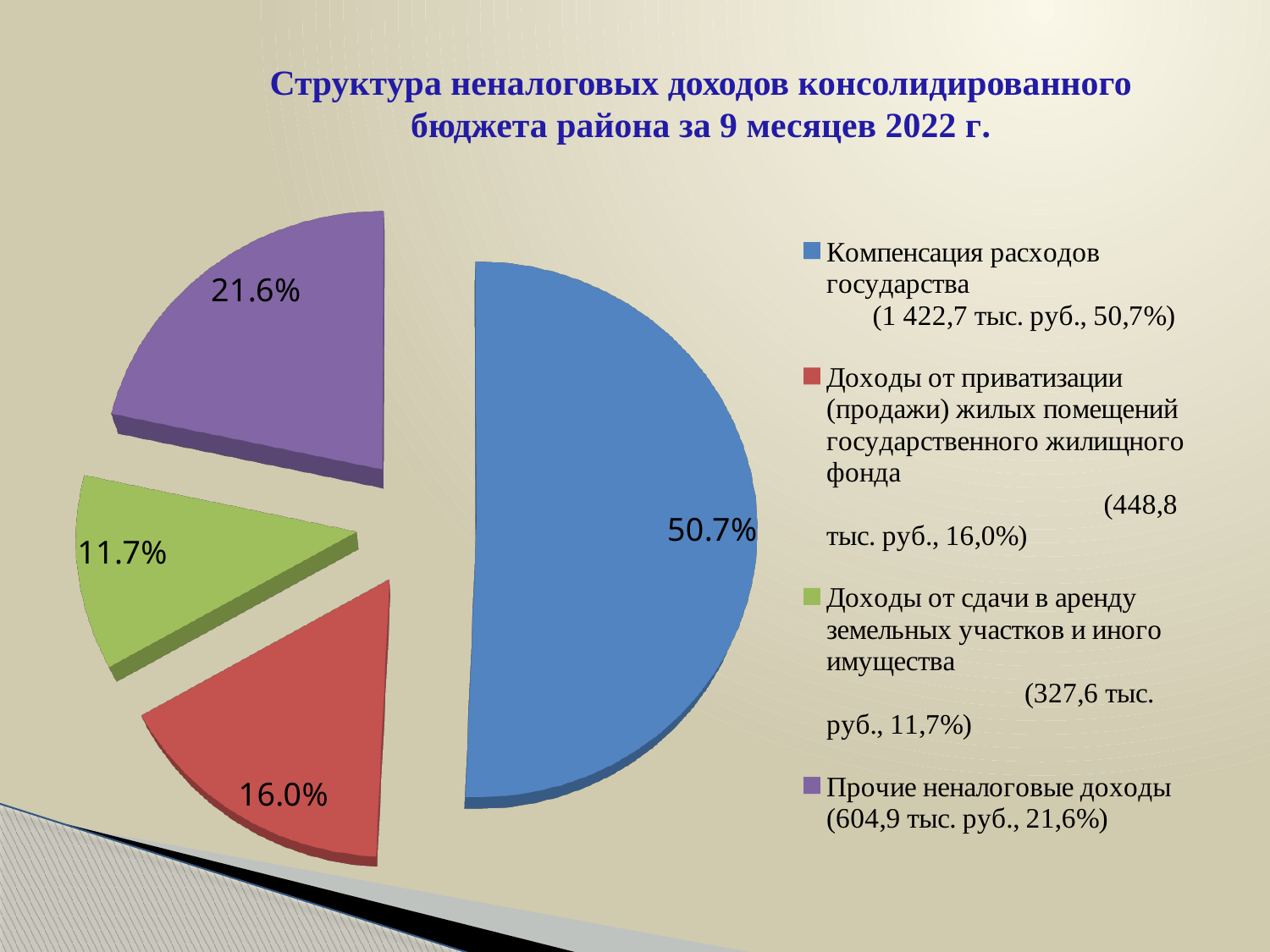
According to the legend, what amount in тыс. руб. corresponds to "Прочие неналоговые доходы"? 604,9 тыс. руб. What share of the pie does "Доходы от сдачи в аренду земельных участков и иного имущества" have? 11.7% How many slices does the pie chart have? 4 What is the difference in percentage points between the "Прочие неналоговые доходы" slice and the "Доходы от приватизации" slice? 5.6 What share of the pie does "Прочие неналоговые доходы" have? 21.6% What kind of chart is shown on the slide? Pie chart Which is larger: the slice for "Прочие неналоговые доходы" or the slice for "Доходы от приватизации (продажи) жилых помещений"? Прочие неналоговые доходы What colour is the slice for "Компенсация расходов государства"? Blue What share of the pie does "Компенсация расходов государства" have? 50.7% Which category has the largest slice of the pie? Компенсация расходов государства Which category has the smallest slice of the pie? Доходы от сдачи в аренду земельных участков и иного имущества